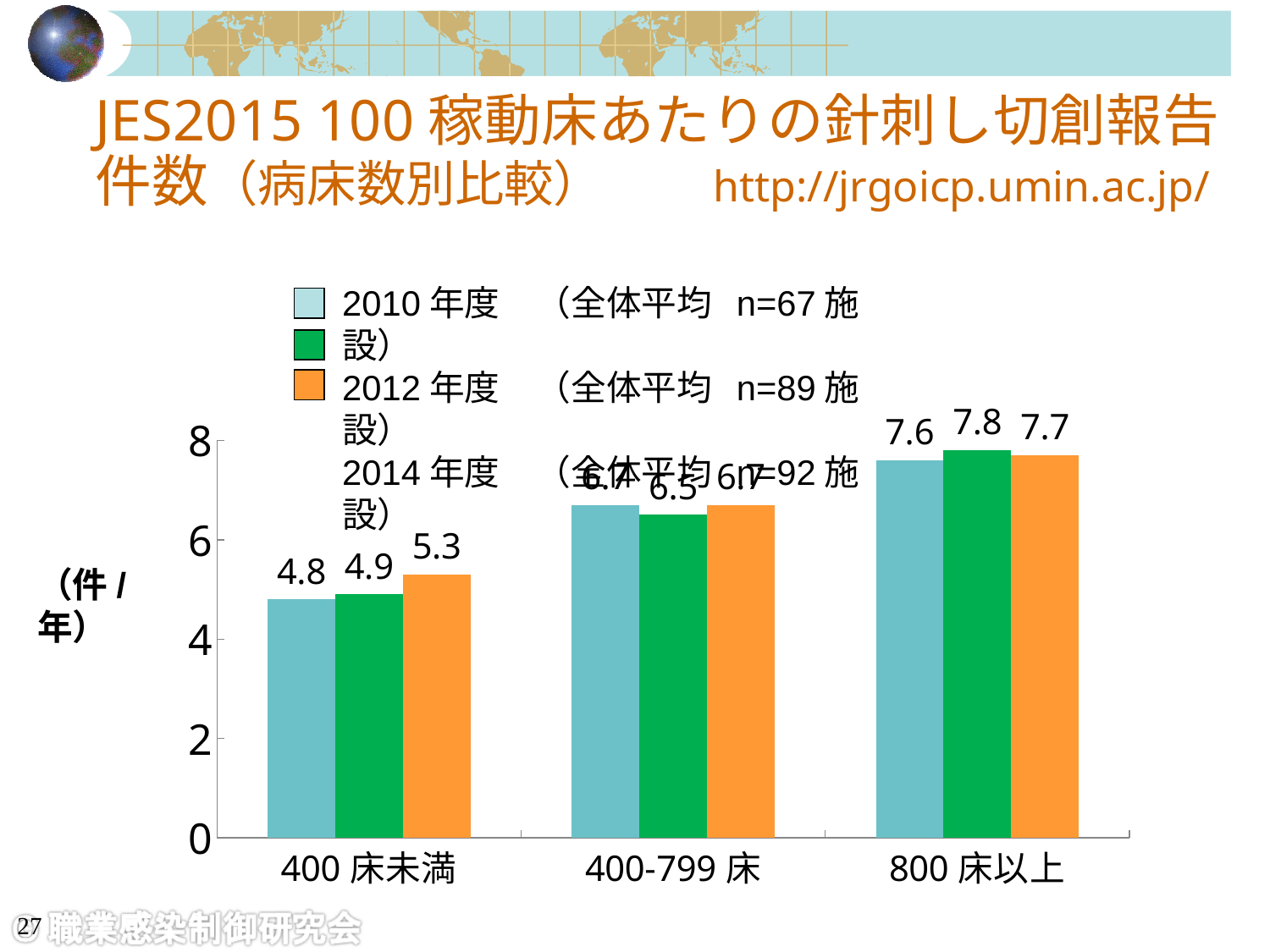
What is the value for 2014年度 in the 400床未満 category? 5.3 In the 800床以上 category, which is larger: the 2012年度 value or the 2014年度 value? 2012年度 In the 400床未満 category, what is the difference between the 2014年度 value and the 2010年度 value? 0.5 What is the value for 2012年度 in the 800床以上 category? 7.8 Which bed-size category has the lowest value for 2010年度? 400床未満 What kind of chart is shown on the slide? bar chart How many bed-size categories are shown on the x axis? 3 What is the value for 2010年度 in the 800床以上 category? 7.6 How many series does the legend list? 3 What is the value for 2012年度 in the 400-799床 category? 6.5 Which bed-size category has the highest value for 2014年度? 800床以上 Is the value for 2010年度 in the 400-799床 category greater or less than 6? greater